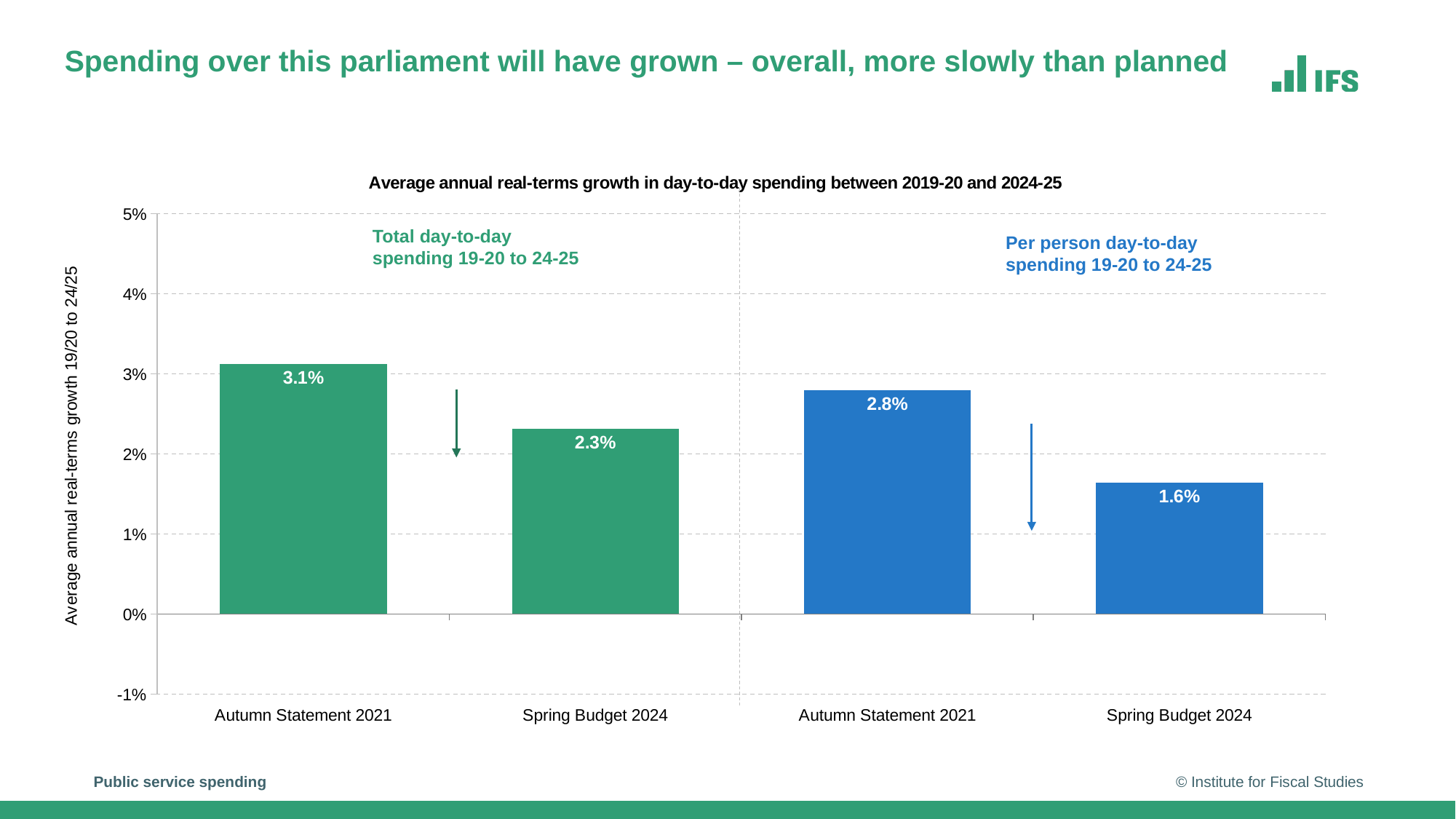
What is the value for Autumn Statement 2021 under Per person day-to-day spending 19-20 to 24-25? 2.8% What is the value for Spring Budget 2024 under Per person day-to-day spending 19-20 to 24-25? 1.6% How many bars are plotted on the chart? 4 Which bar has the highest value on the chart? Autumn Statement 2021 (Total day-to-day spending) Which is larger: the Spring Budget 2024 value for Total day-to-day spending or the Spring Budget 2024 value for Per person day-to-day spending? Total day-to-day spending (2.3%) What is the value for Spring Budget 2024 under Total day-to-day spending 19-20 to 24-25? 2.3% What is the difference between the Autumn Statement 2021 and Spring Budget 2024 values for Per person day-to-day spending? 1.2% What is the value for Autumn Statement 2021 under Total day-to-day spending 19-20 to 24-25? 3.1% What kind of chart is shown on the slide? Bar chart What is the title of the chart? Average annual real-terms growth in day-to-day spending between 2019-20 and 2024-25 Which bar has the lowest value on the chart? Spring Budget 2024 (Per person day-to-day spending) What is the difference between the Autumn Statement 2021 and Spring Budget 2024 values for Total day-to-day spending? 0.8%